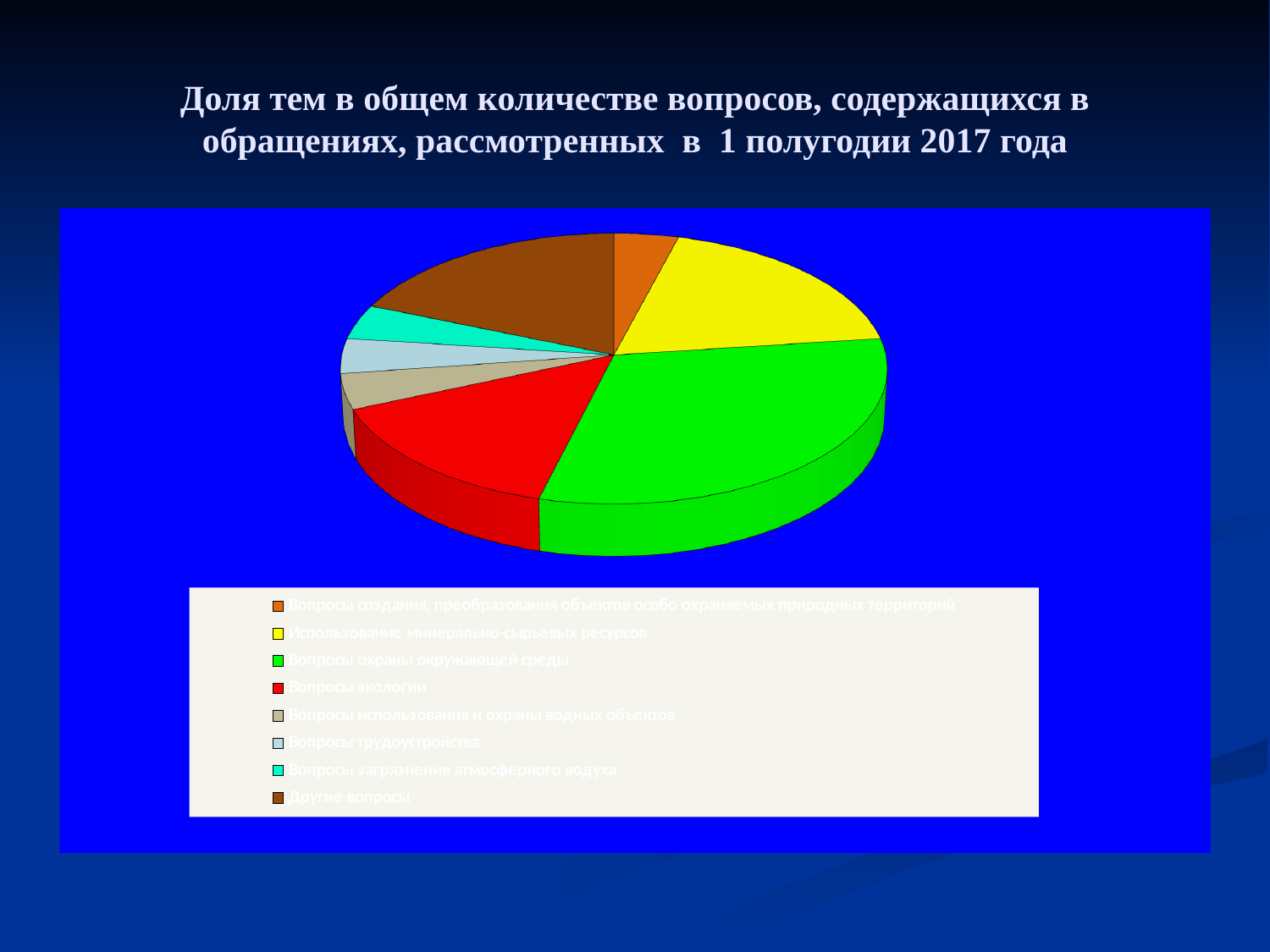
Which slice is larger: Другие вопросы or Вопросы использования и охраны водных объектов? Другие вопросы What colour represents Вопросы экологии in the pie chart? red What kind of chart is shown on the slide? pie chart Which slice is larger: Использование минерально-сырьевых ресурсов or Вопросы трудоустройства? Использование минерально-сырьевых ресурсов Which slice is larger: Вопросы охраны окружающей среды or Вопросы экологии? Вопросы охраны окружающей среды Which category has the largest slice of the pie chart? Вопросы охраны окружающей среды What is the title of the slide's chart? Доля тем в общем количестве вопросов, содержащихся в обращениях, рассмотренных в 1 полугодии 2017 года How many categories does the legend of the pie chart list? 8